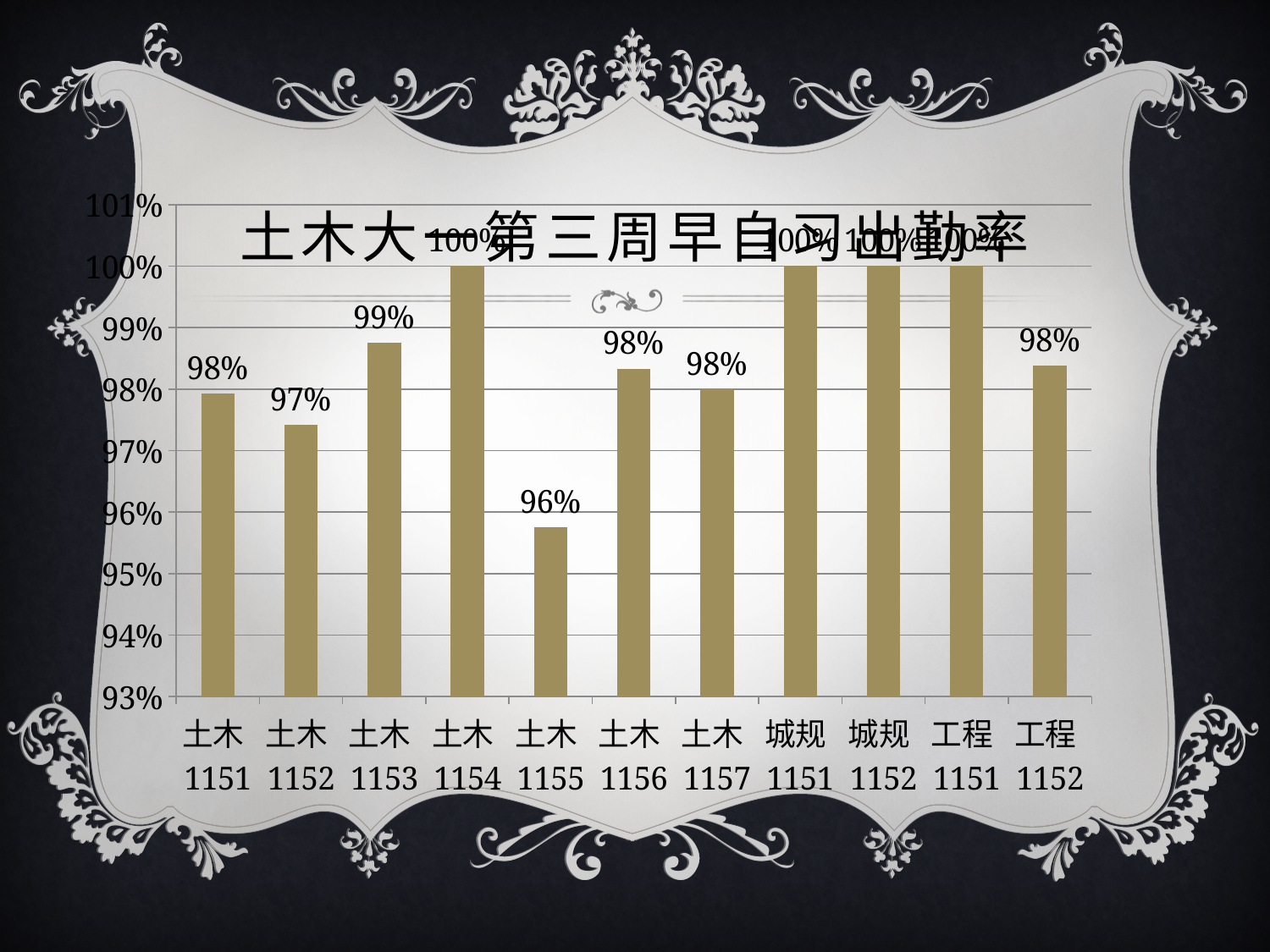
What is the value for 土木1153? 99% Is the value for 土木1155 greater or less than 97%? less What is the difference between the values for 土木1154 and 土木1155? 4% What is the value for 城规1152? 100% How many categories are shown on the x axis? 11 Which category has the lowest value? 土木1155 What is the value for 土木1151? 98% Which is larger, the value for 土木1153 or the value for 土木1152? 土木1153 What kind of chart is shown on the slide? bar chart What is the value for 工程1152? 98% What is the value for 土木1155? 96% What is the value for 土木1152? 97%